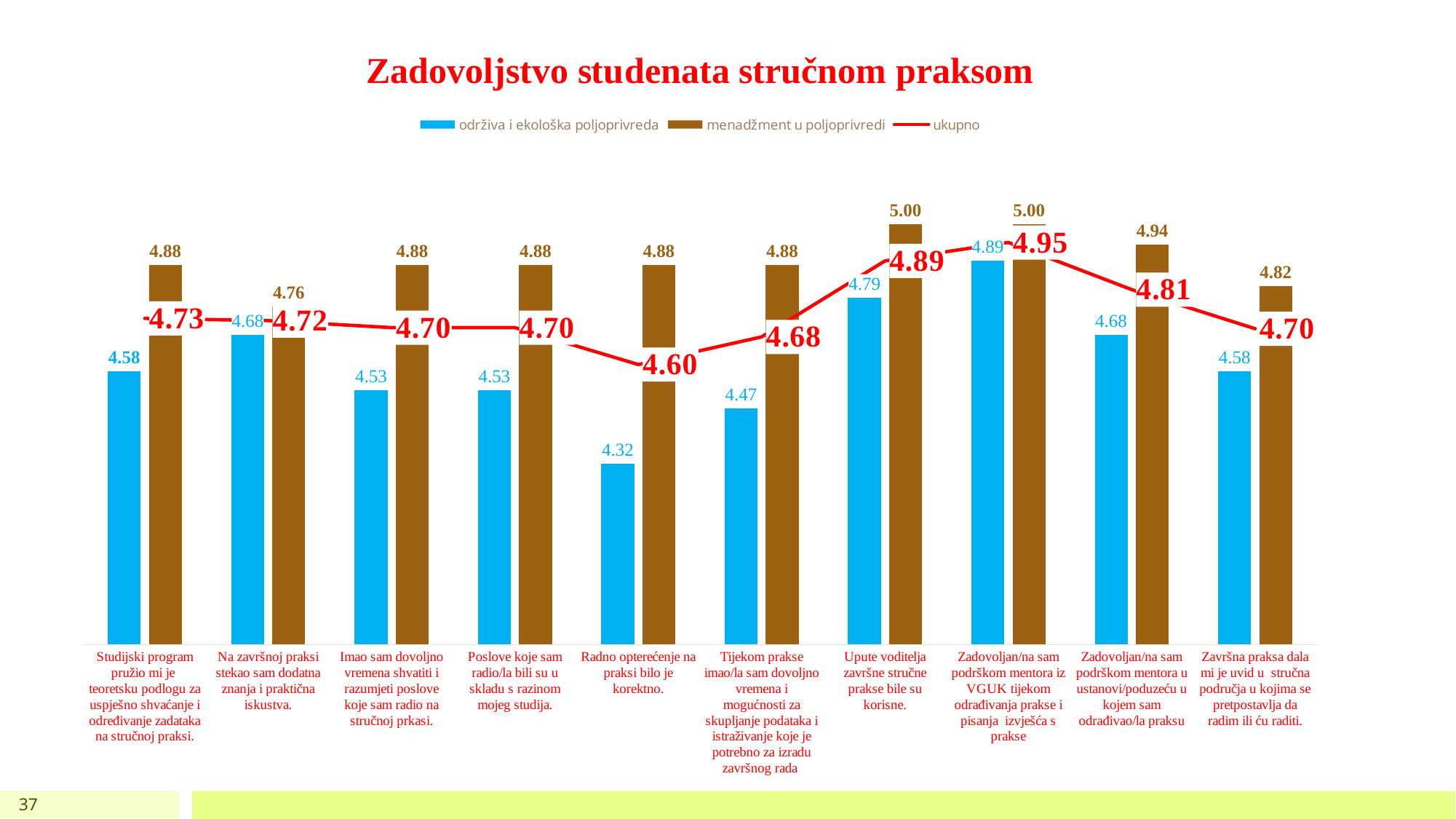
What is the title of the chart? Zadovoljstvo studenata stručnom praksom For the category 'Na završnoj praksi stekao sam dodatna znanja i praktična iskustva.', which series has the larger value: 'održiva i ekološka poljoprivreda' or 'menadžment u poljoprivredi'? menadžment u poljoprivredi What is the value for 'održiva i ekološka poljoprivreda' for the category 'Radno opterećenje na praksi bilo je korektno.'? 4.32 Which category has the highest 'ukupno' value? Zadovoljan/na sam podrškom mentora iz VGUK tijekom odrađivanja prakse i pisanja izvješća s prakse Which category has the lowest value for 'održiva i ekološka poljoprivreda'? Radno opterećenje na praksi bilo je korektno. What kind of chart is shown on the slide? Bar chart with a line What is the value for 'menadžment u poljoprivredi' for the category 'Zadovoljan/na sam podrškom mentora u ustanovi/poduzeću u kojem sam odrađivao/la praksu'? 4.94 How many categories are shown on the x axis of the chart? 10 How many series does the legend list? 3 What is the difference between the 'menadžment u poljoprivredi' and 'održiva i ekološka poljoprivreda' values for the category 'Radno opterećenje na praksi bilo je korektno.'? 0.56 What is the 'ukupno' value for the category 'Upute voditelja završne stručne prakse bile su korisne.'? 4.89 Which series is shown as a red line in the chart? ukupno